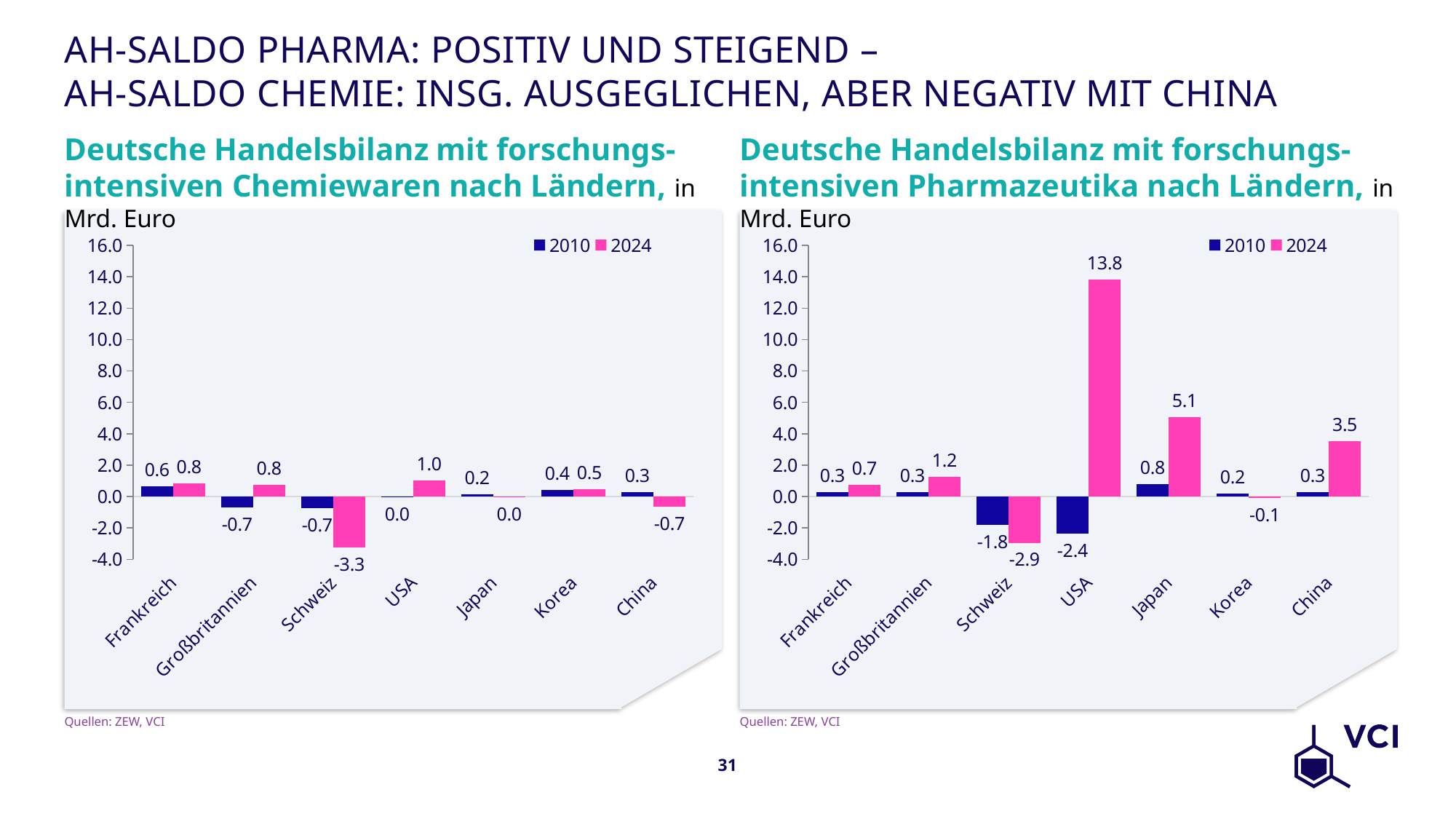
In the left chart (Chemiewaren), which is larger: the 2024 value for USA or the 2024 value for Korea? USA How many countries are shown on the x axis of the left chart (Chemiewaren)? 7 In the right chart (Pharmazeutika), what is the difference between the 2024 and 2010 values for USA? 16.2 In the left chart (Chemiewaren), which country has the lowest 2024 value? Schweiz How many series does the legend of the right chart (Pharmazeutika) list? 2 In the left chart (Chemiewaren), what is the 2024 value for China? -0.7 In the right chart (Pharmazeutika), is the 2024 value for Japan greater or less than 4.0? greater In the right chart (Pharmazeutika), what is the 2010 value for Japan? 0.8 In the left chart (Chemiewaren), what is the 2024 value for Schweiz? -3.3 In the right chart (Pharmazeutika), which country has the highest 2024 value? USA In the right chart (Pharmazeutika), what is the 2024 value for USA? 13.8 What type of chart is the left chart (Chemiewaren)? Bar chart